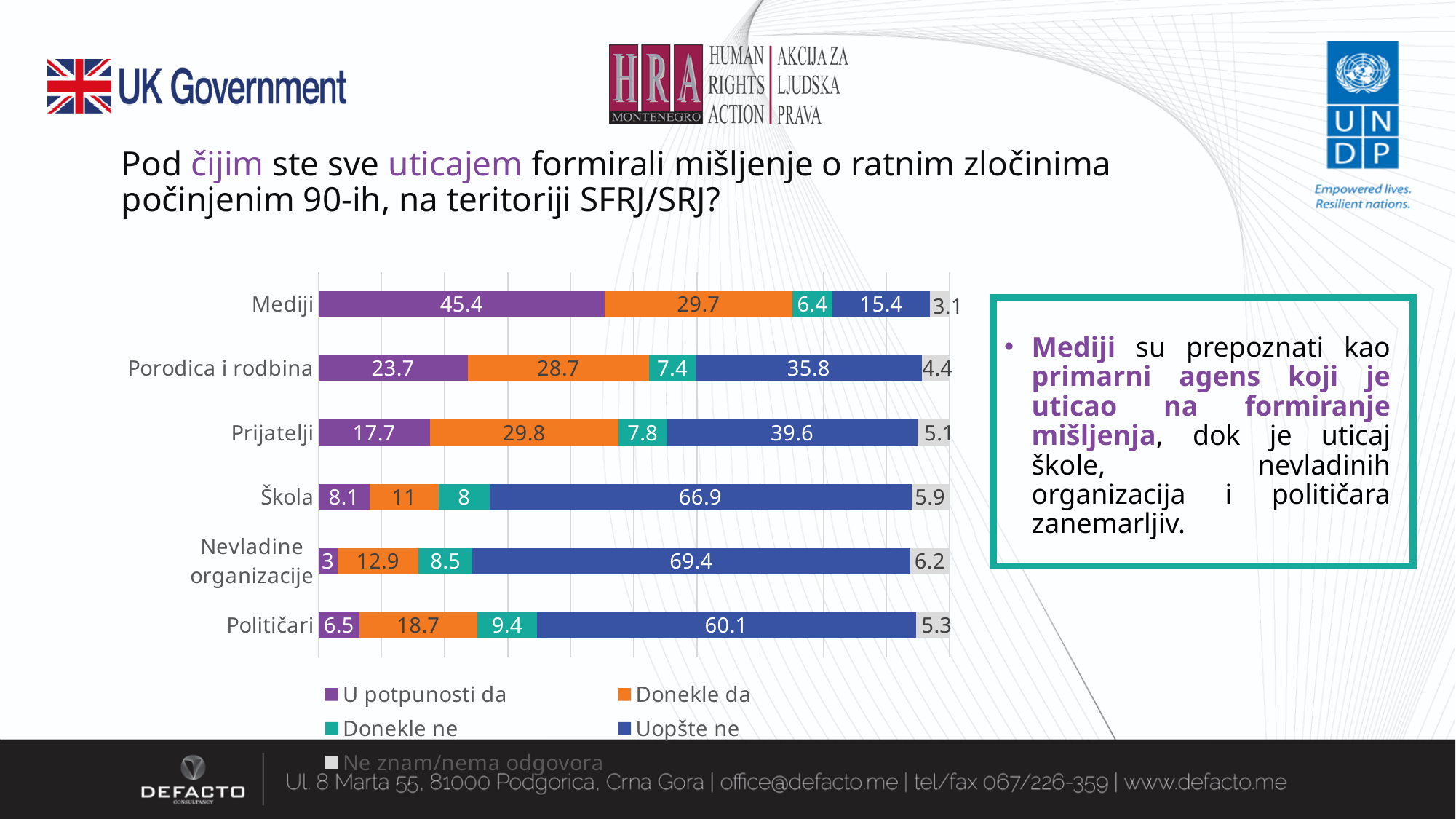
Which category has the highest value for "U potpunosti da"? Mediji What is the value of "Donekle ne" for Političari? 9.4 How many series does the legend list? 5 What is the value of "Uopšte ne" for Škola? 66.9 What is the difference between the "U potpunosti da" values for Mediji and Porodica i rodbina? 21.7 What kind of chart is shown on the slide? Stacked bar chart How many categories are shown on the chart? 6 Which category has the lowest value for "U potpunosti da"? Nevladine organizacije Which has the larger "Donekle da" value, Političari or Škola? Političari What is the value of "U potpunosti da" for Mediji? 45.4 What is the value of "Ne znam/nema odgovora" for Porodica i rodbina? 4.4 Which category has the highest value for "Uopšte ne"? Nevladine organizacije